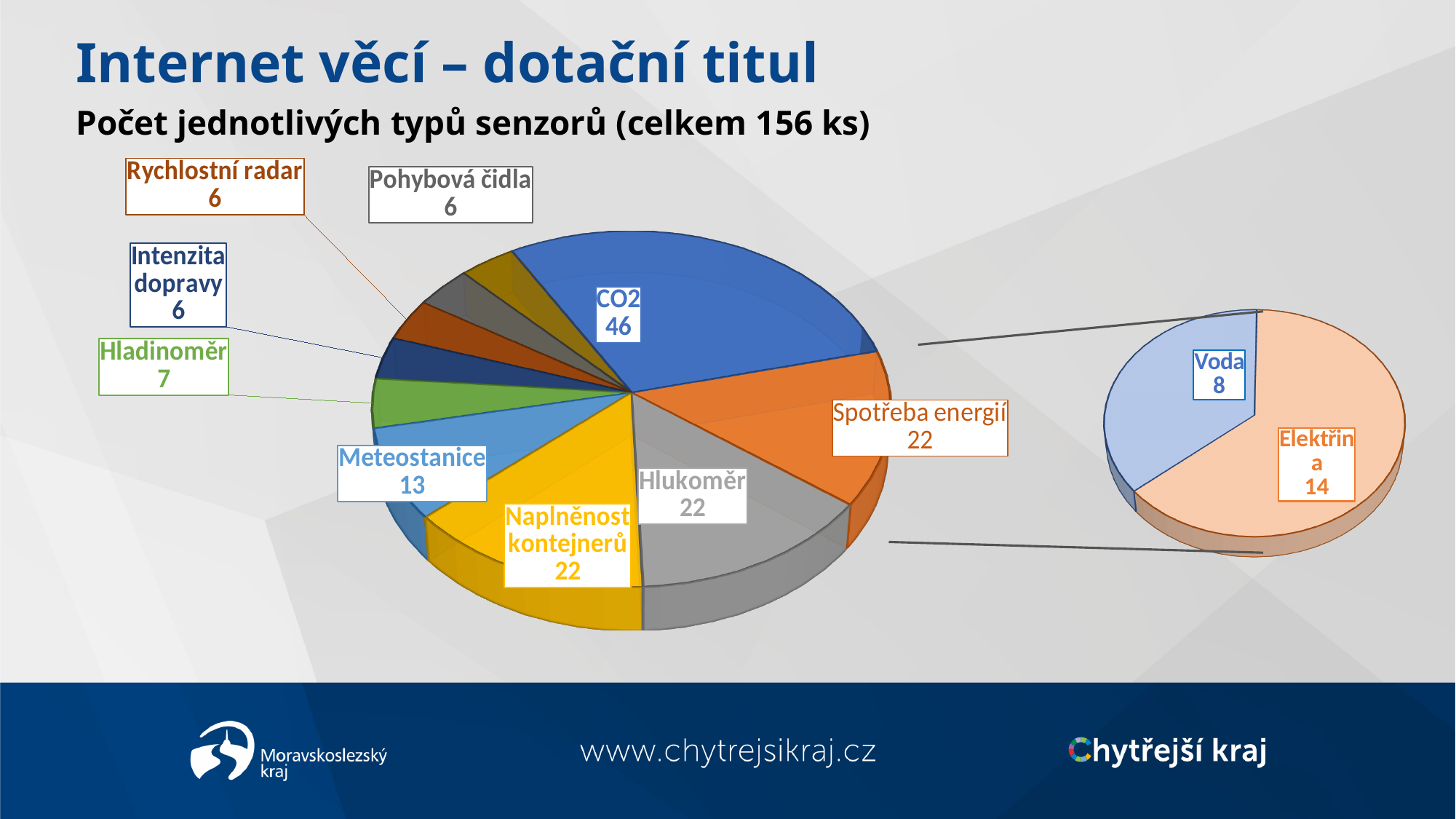
What is the total of the two slices in the smaller pie chart (Voda and Elektřina)? 22 How many slices does the smaller pie chart on the right have? 2 Which slice is smaller in the secondary pie chart, Voda or Elektřina? Voda What is the value for Voda in the smaller pie chart? 8 Which is larger, the value for Meteostanice or the value for Hladinoměr? Meteostanice Which category has the highest value in the main pie chart? CO2 What is the value for Hladinoměr? 7 What is the value for Meteostanice? 13 What is the value for CO2 in the main pie chart? 46 What is the difference between the values for CO2 and Hlukoměr? 24 What is the value for Elektřina in the smaller pie chart? 14 What type of chart is shown on the slide? Pie chart